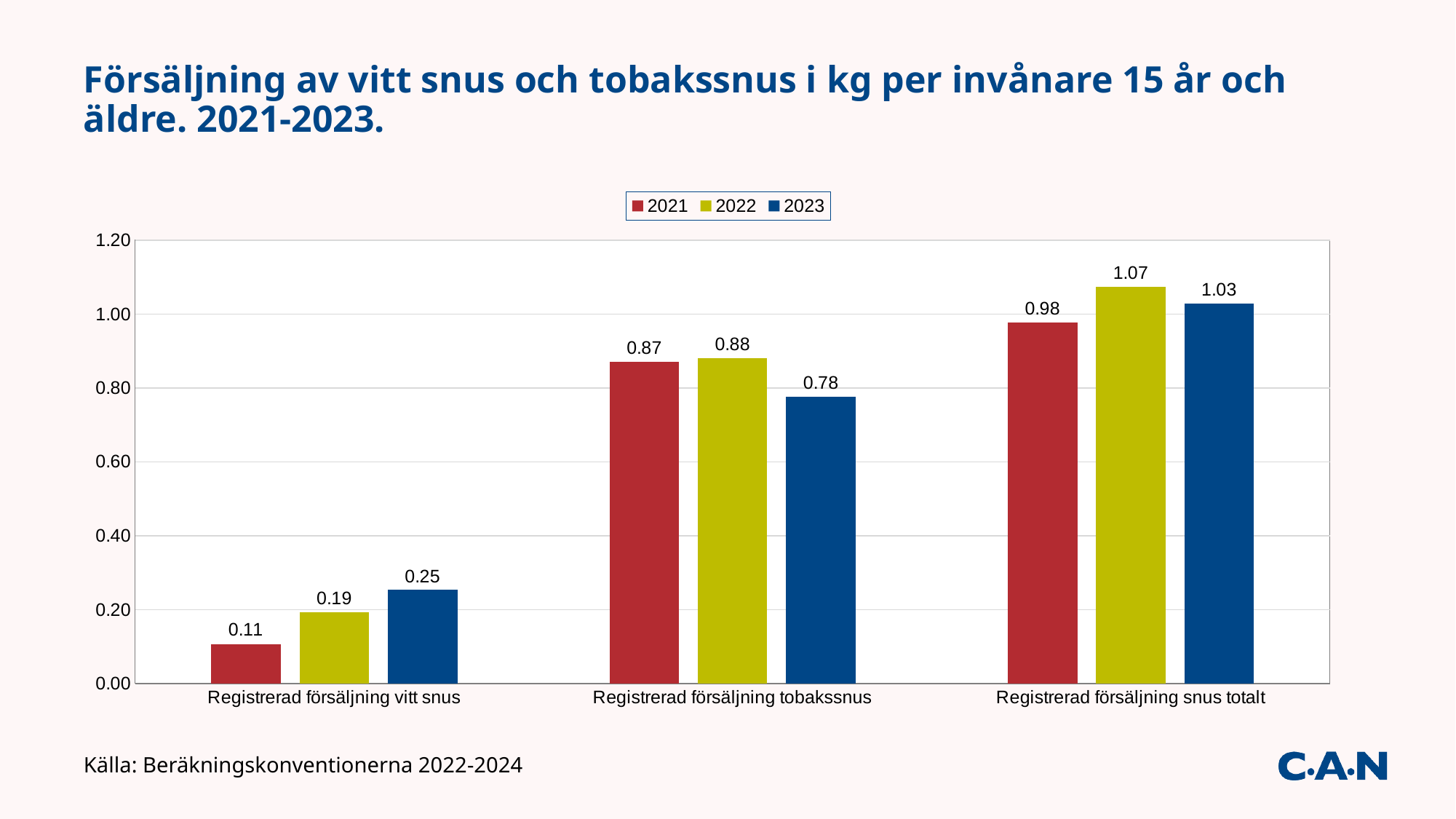
Which is larger: the 2022 value or the 2023 value for 'Registrerad försäljning tobakssnus'? 2022 Is the 2023 value for 'Registrerad försäljning tobakssnus' greater or less than 0.80? less Which year has the highest value in the 'Registrerad försäljning snus totalt' category? 2022 Which year has the lowest value in the 'Registrerad försäljning vitt snus' category? 2021 What is the value for 2022 in the 'Registrerad försäljning snus totalt' category? 1.07 What is the difference between the 2023 and 2021 values for 'Registrerad försäljning vitt snus'? 0.14 What is the value for 2021 in the 'Registrerad försäljning tobakssnus' category? 0.87 What is the value for 2023 in the 'Registrerad försäljning vitt snus' category? 0.25 How many series does the legend list? 3 What kind of chart is shown on the slide? Bar chart Which colour represents the 2022 series in the legend? Yellow-green How many categories are shown on the x axis? 3